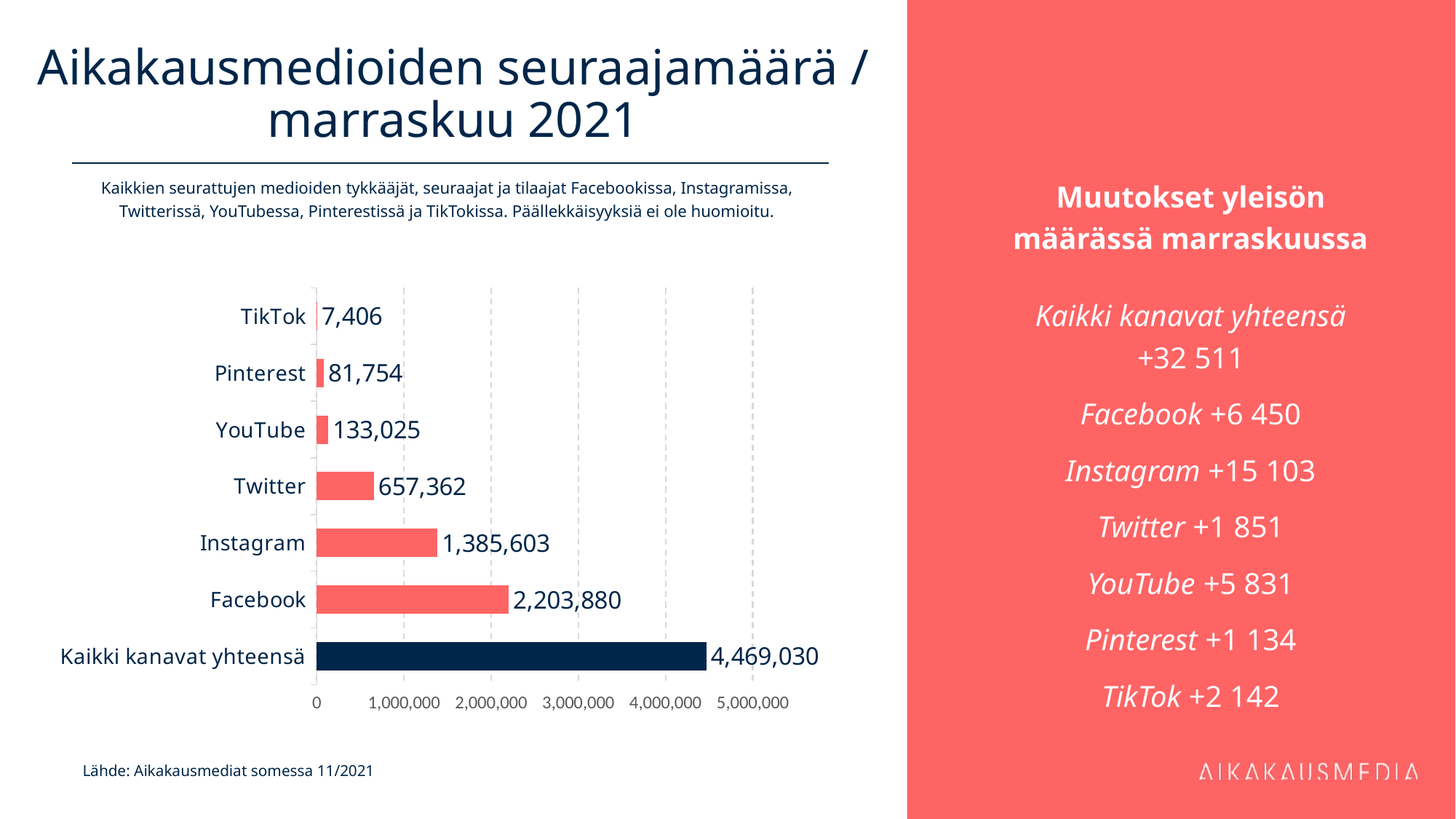
What is the value shown for Instagram? 1,385,603 Which individual channel (excluding the total bar) has the highest value? Facebook Is the value for Facebook greater or less than 2,000,000? greater What is the value shown for TikTok? 7,406 What is the value shown for Kaikki kanavat yhteensä? 4,469,030 What is the difference between the values for Facebook and Instagram? 818,277 How many categories are shown in the chart? 7 Which is larger, the value for Twitter or the value for YouTube? Twitter Which bar is coloured dark navy instead of red? Kaikki kanavat yhteensä What is the value shown for Facebook? 2,203,880 Which category has the lowest value? TikTok What kind of chart is shown on the slide? bar chart